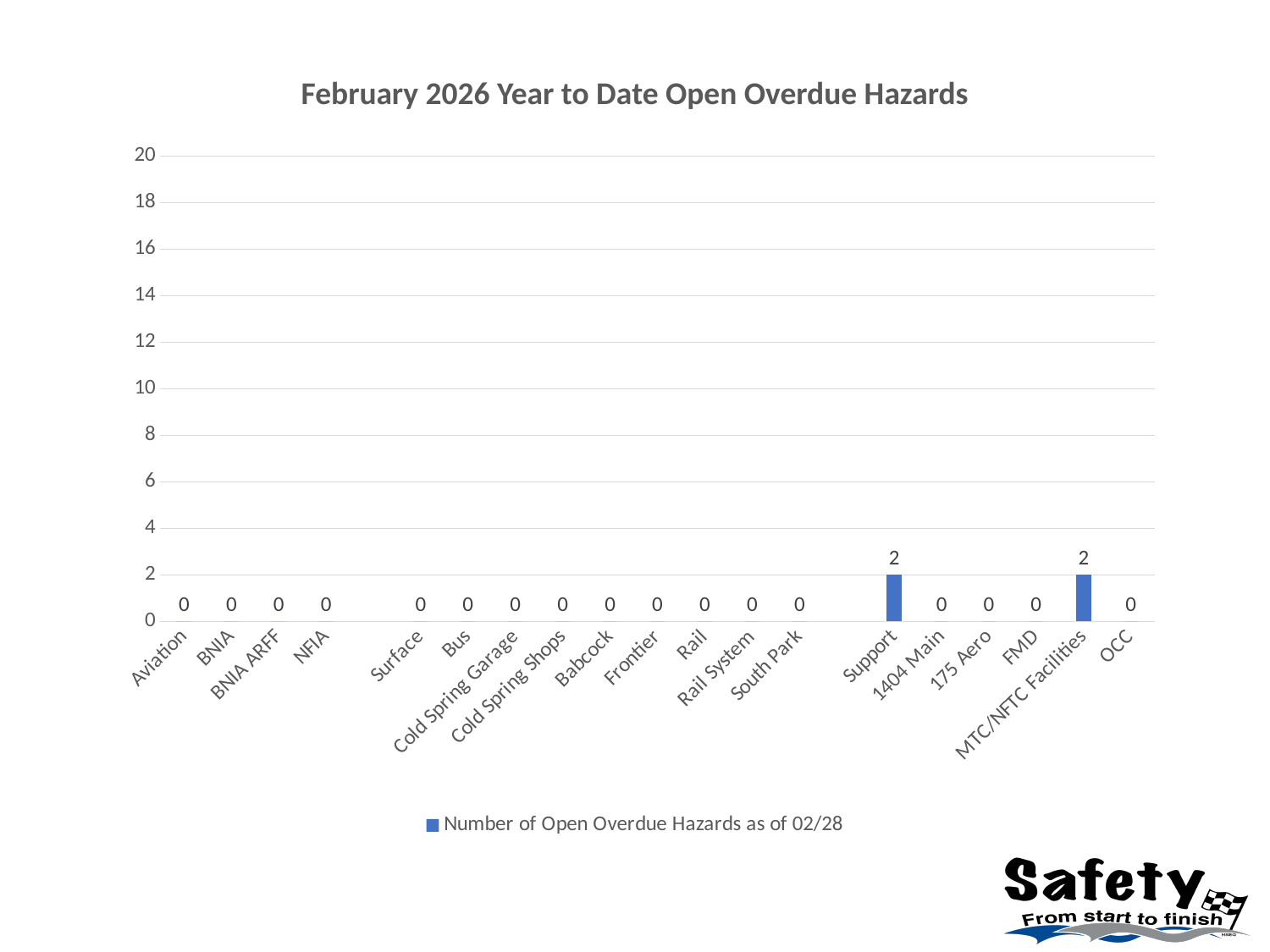
What is the value for Support? 2 What is the value for Aviation? 0 What kind of chart is shown on the slide? bar chart What is the title of the chart? February 2026 Year to Date Open Overdue Hazards What is the difference between the values for Support and Bus? 2 Which categories have the highest number of open overdue hazards? Support and MTC/NFTC Facilities Is the value for Support greater or less than 4? less What is the value for Babcock? 0 How many categories are labelled on the x axis? 19 How many series does the legend list? 1 Which is larger, the value for Support or the value for OCC? Support What is the value for MTC/NFTC Facilities? 2